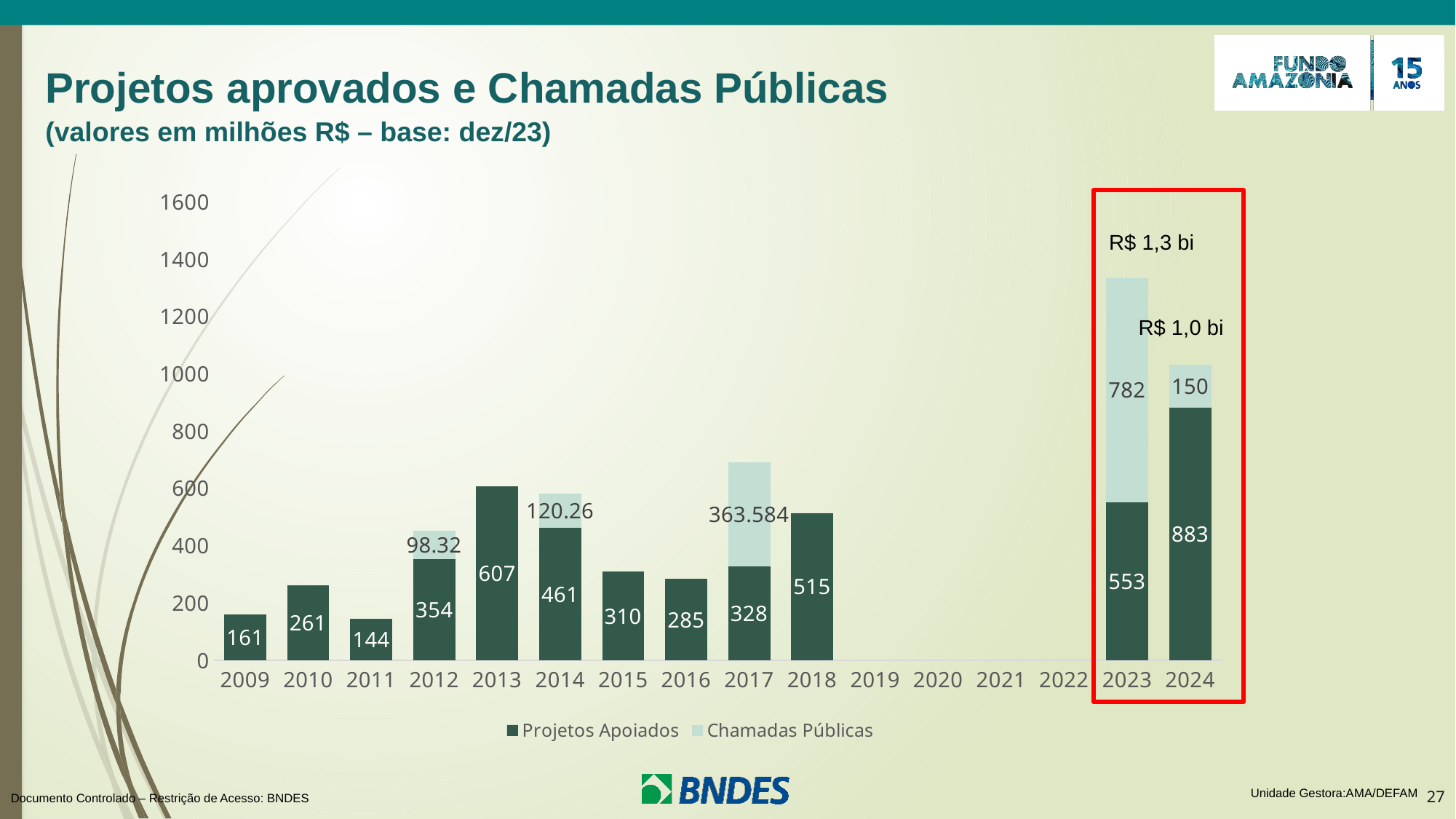
Which year has the larger Chamadas Públicas value, 2023 or 2024? 2023 Which year has the highest value for Projetos Apoiados? 2024 What is the value of Chamadas Públicas for 2017? 363.584 What kind of chart is shown on the slide? Stacked bar chart What is the difference between the Projetos Apoiados values for 2024 and 2023? 330 What is the value of Chamadas Públicas for 2024? 150 What is the total of the stacked bar for 2023 (Projetos Apoiados plus Chamadas Públicas)? 1335 What is the value of Projetos Apoiados for 2013? 607 What is the total of the stacked bar for 2014? 581.26 Which year has the lowest value for Projetos Apoiados? 2011 Do the Projetos Apoiados values rise or fall from 2011 to 2013? Rise How many series does the legend list? 2